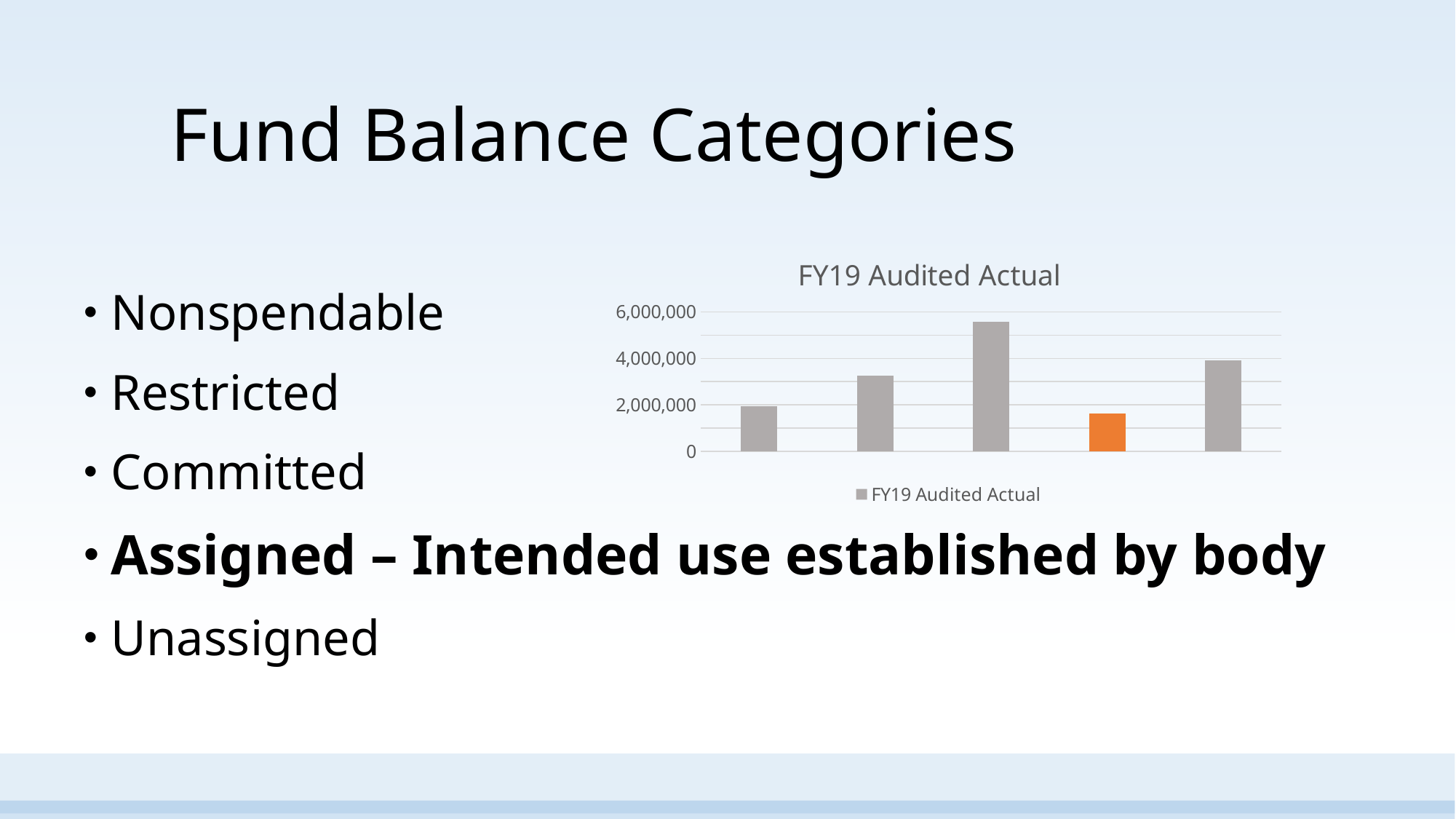
What is the title of the chart? FY19 Audited Actual Which is larger, the second bar or the fifth bar? the fifth bar What kind of chart is shown on the slide? bar chart Is the value of the second bar greater or less than 2,000,000? greater How many bars are plotted in the chart? 5 Which bar in the chart is the shortest? the fourth (orange) bar Which bar in the chart is a different colour from the others? the fourth bar (orange) How many series does the chart legend list? 1 Is the value of the orange bar greater or less than 2,000,000? less Which bar in the chart is the tallest? the third bar Which is larger, the third bar or the fifth bar? the third bar Is the value of the third bar greater or less than 4,000,000? greater